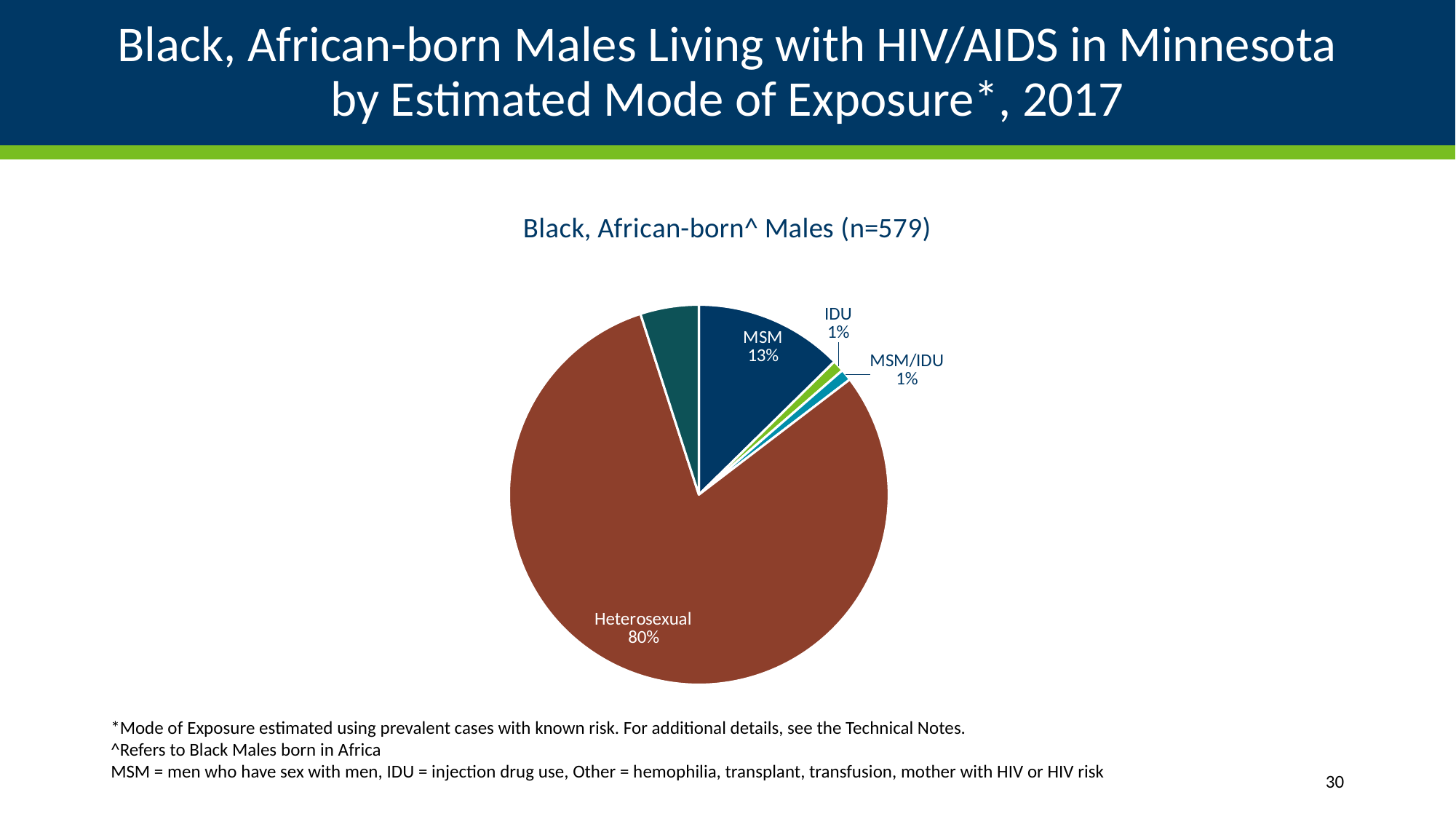
What percentage is shown for the MSM/IDU slice? 1% What percentage is shown for the IDU slice? 1% What percentage is shown for the MSM slice? 13% What share of the pie is labeled Heterosexual? 80% Which slice is larger, MSM or Heterosexual? Heterosexual What is the title printed above the pie chart? Black, African-born^ Males (n=579) What is the sample size (n) given in the chart title? 579 How many slices does the pie chart have? 5 Which mode of exposure has the largest slice of the pie? Heterosexual What is the difference in percentage points between the Heterosexual slice and the MSM slice? 67 What kind of chart is shown on the slide? pie chart